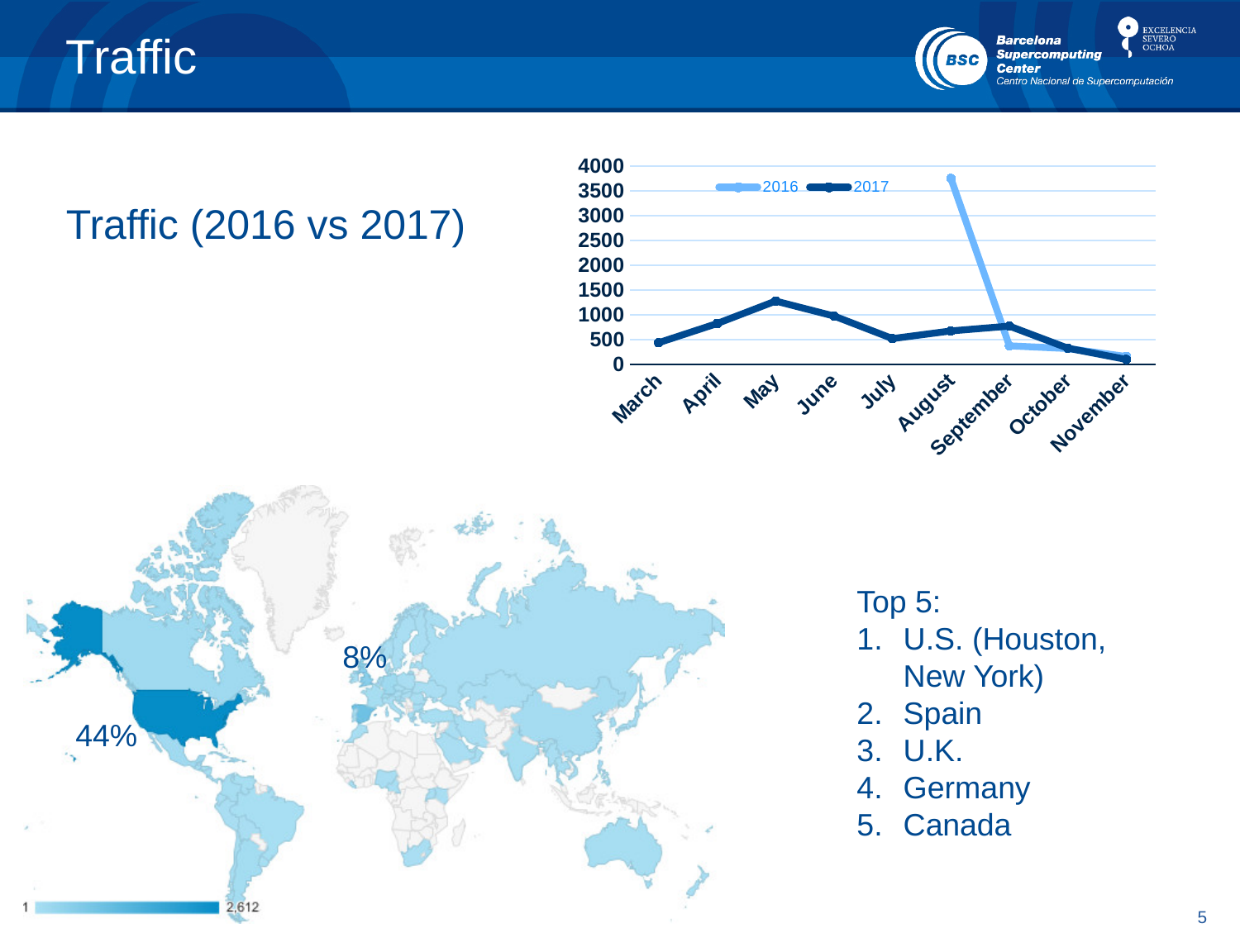
What kind of chart is shown on the slide? line chart Is the value for 2017 in October greater or less than 500? less How many series does the legend of the line chart list? 2 Which two series are listed in the legend of the line chart? 2016 and 2017 Is the value for 2016 in August greater or less than 3000? greater In which month does the 2016 series reach its highest value? August Does the 2016 series rise or fall from August to November? fall In August, which series has the larger value, 2016 or 2017? 2016 In which month does the 2017 series reach its highest value? May In which month does the 2017 series reach its lowest value? November How many months are shown on the x axis of the line chart? 9 Is the value for 2017 in May greater or less than 1000? greater